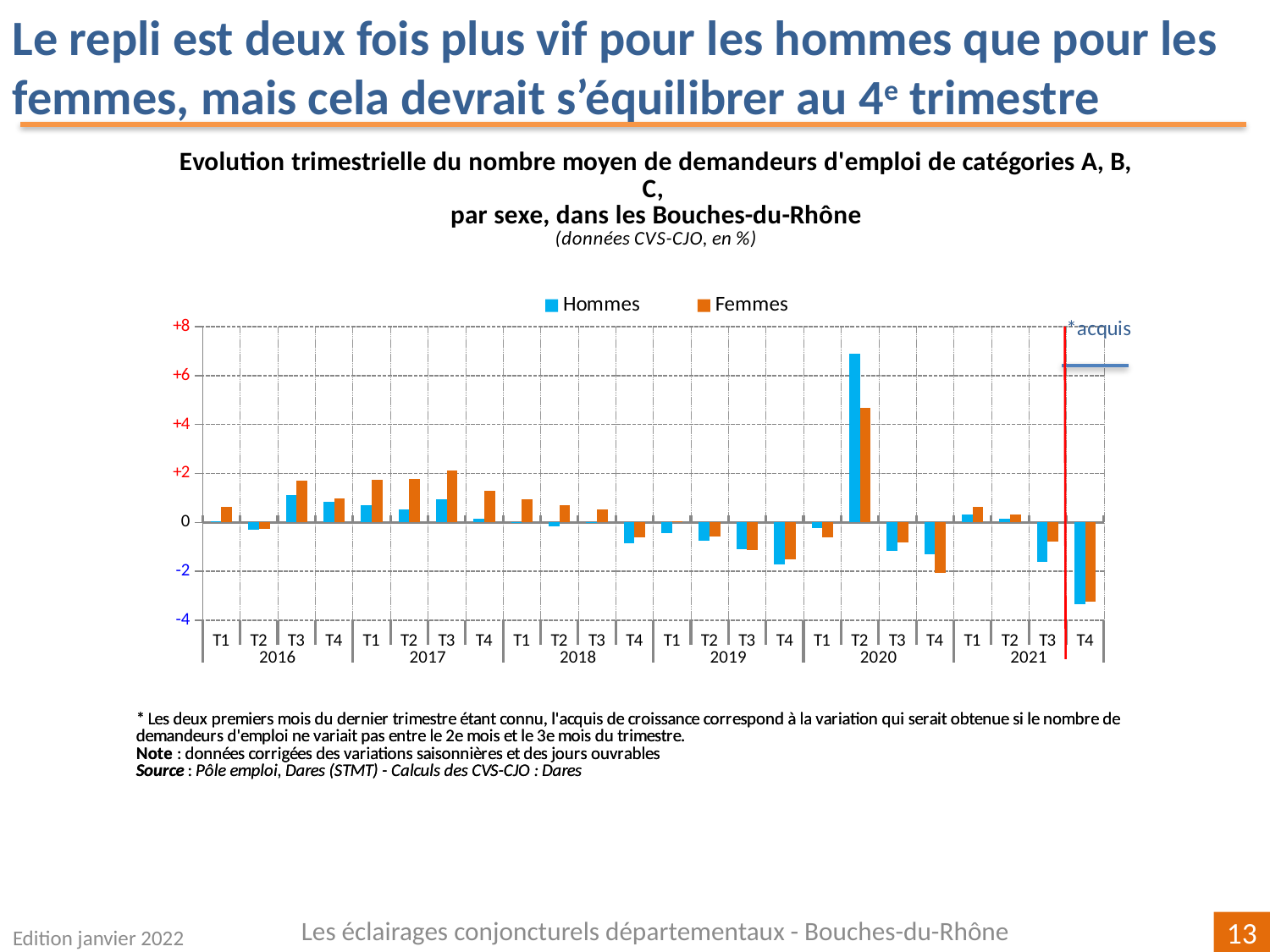
Is the value for Hommes in T2 2020 greater or less than +6? greater How many series does the legend list? 2 In which quarter is the value for Hommes lowest? T4 2021 In T2 2020, which series has the larger value, Hommes or Femmes? Hommes How many quarters are plotted on the x axis? 24 Is the value for Femmes in T2 2020 greater or less than +4? greater Which series is shown in blue? Hommes Is the value for Hommes in T4 2021 greater or less than -2? less In T3 2017, which series has the larger value, Hommes or Femmes? Femmes What kind of chart is shown on the slide? bar chart In which quarter is the value for Hommes highest? T2 2020